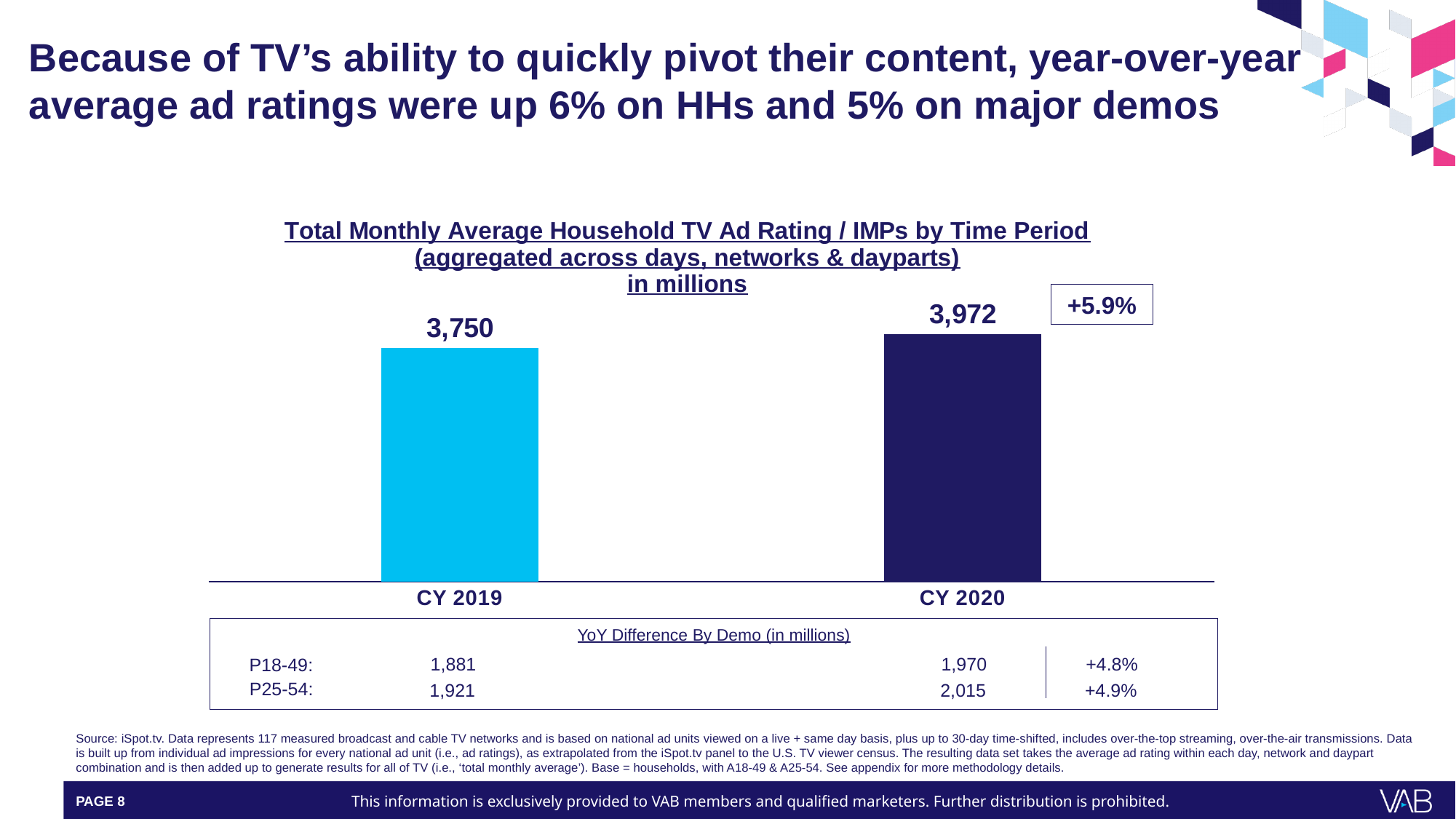
What is the value for CY 2019? 3,750 Is the value for CY 2020 larger than the value for CY 2019? Yes What year-over-year percentage change is shown in the box next to the CY 2020 bar? +5.9% What is the value for CY 2020? 3,972 What unit is stated in the chart title? in millions What is the difference between the CY 2020 and CY 2019 values? 222 Which time period has the higher value? CY 2020 Do the values rise or fall from CY 2019 to CY 2020? Rise What kind of chart is shown on the slide? Bar chart Which time period has the lower value? CY 2019 How many time periods are plotted in the chart? 2